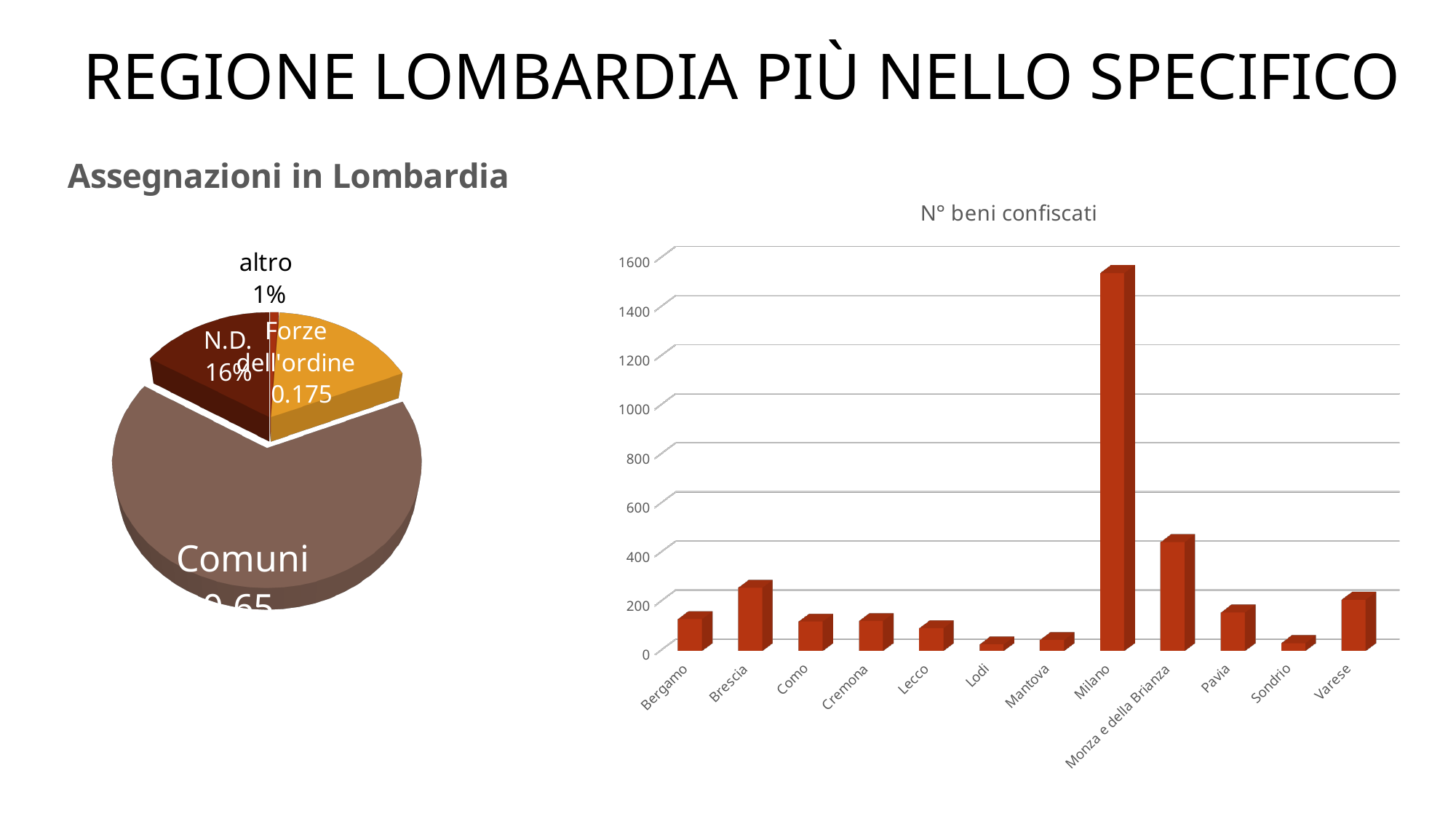
In the "N° beni confiscati" chart, is the value for Monza e della Brianza greater or less than 400? greater In the "N° beni confiscati" chart, which province has the highest value? Milano What kind of chart is the chart titled "Assegnazioni in Lombardia"? pie chart In the "N° beni confiscati" chart, is the value for Milano greater or less than 1400? greater What kind of chart is the chart titled "N° beni confiscati"? bar chart In the "N° beni confiscati" chart, which is larger, the value for Brescia or the value for Como? Brescia In the "Assegnazioni in Lombardia" pie chart, what value is labelled for Forze dell'ordine? 0.175 In the "Assegnazioni in Lombardia" pie chart, what share is labelled for altro? 1% In the "N° beni confiscati" chart, which is larger, the value for Monza e della Brianza or the value for Pavia? Monza e della Brianza In the "Assegnazioni in Lombardia" pie chart, what share is labelled for N.D.? 16% In the "N° beni confiscati" chart, is the value for Bergamo greater or less than 200? less How many provinces are shown on the x axis of the "N° beni confiscati" chart? 12